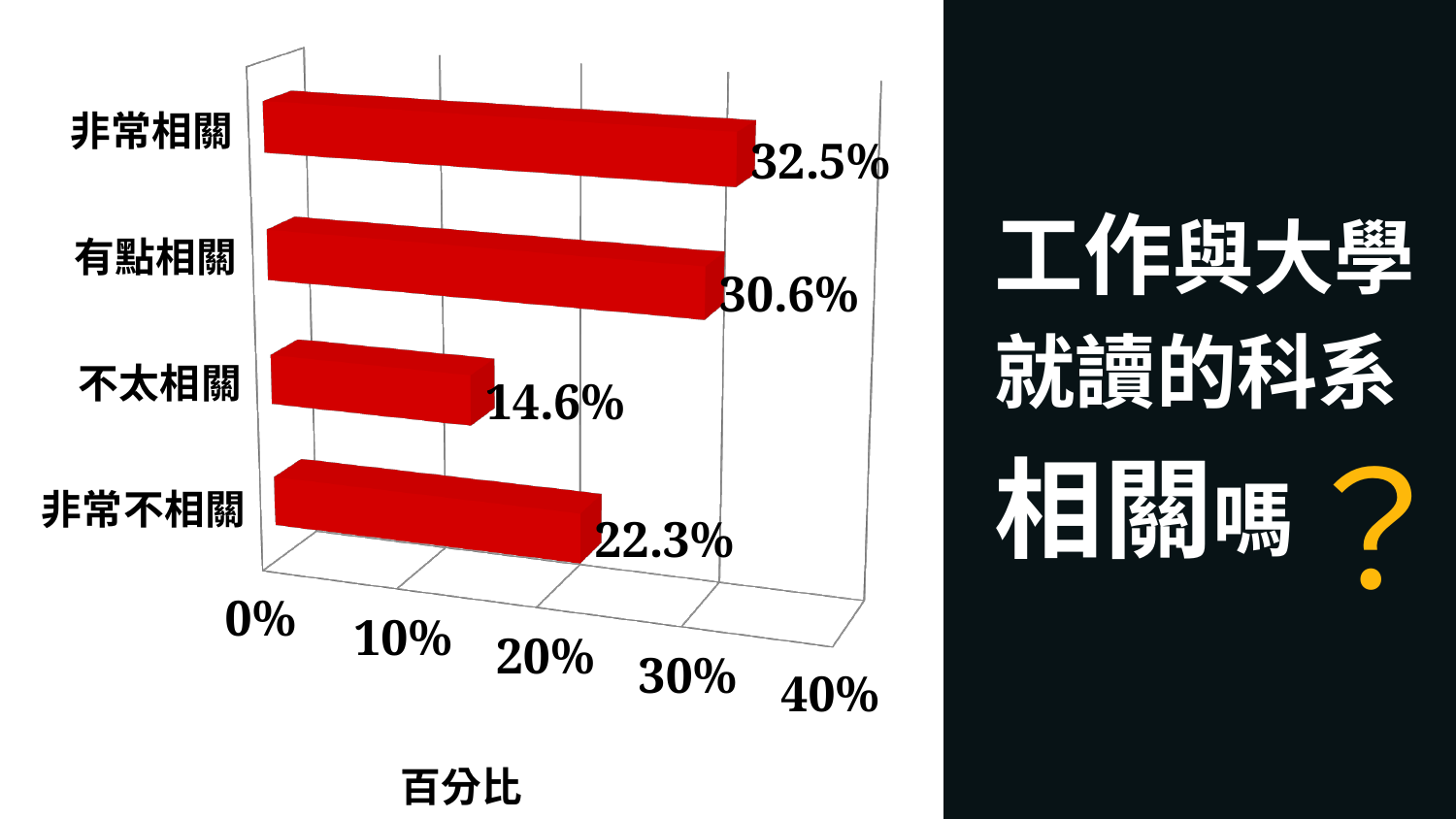
What is the difference between the values for 非常相關 and 有點相關? 1.9% What is the value for 非常不相關? 22.3% Which category has the lowest value? 不太相關 What is the value for 有點相關? 30.6% What is the value for 不太相關? 14.6% Which category has the highest value? 非常相關 What is the difference between the values for 非常不相關 and 不太相關? 7.7% How many categories are shown in the chart? 4 What is the label of the horizontal axis? 百分比 Which is larger, the value for 非常不相關 or the value for 不太相關? 非常不相關 What kind of chart is shown on the slide? bar chart What is the value for 非常相關? 32.5%